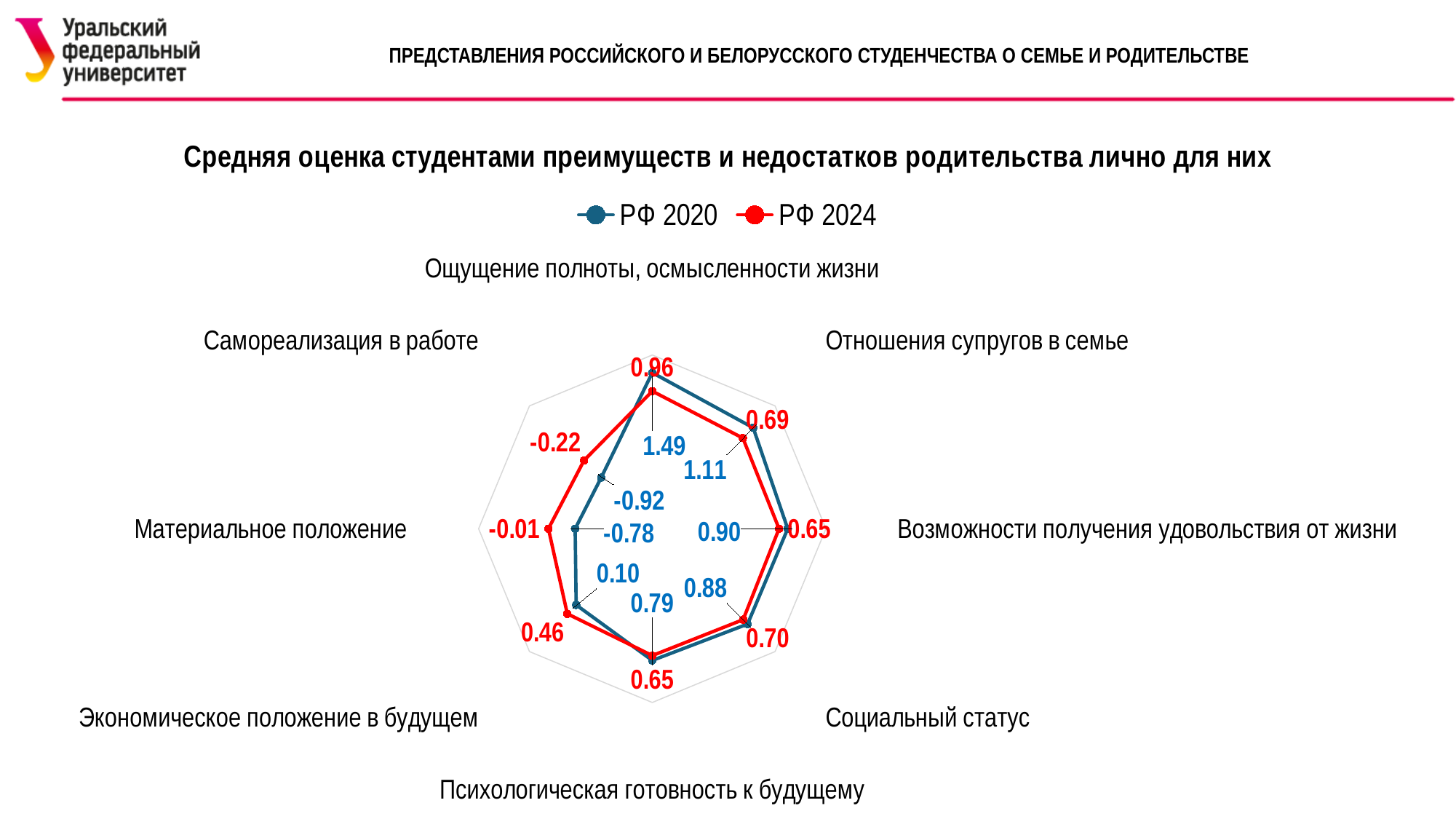
How many categories (axes) does the radar chart have? 8 What is the value for РФ 2020 for 'Самореализация в работе'? -0.92 What kind of chart is shown on the slide? Radar chart What is the difference between the РФ 2020 and РФ 2024 values for 'Отношения супругов в семье'? 0.42 Which category has the highest value for РФ 2020? Ощущение полноты, осмысленности жизни What is the value for РФ 2024 for 'Ощущение полноты, осмысленности жизни'? 0.96 What is the value for РФ 2024 for 'Материальное положение'? -0.01 For 'Экономическое положение в будущем', which series has the larger value, РФ 2020 or РФ 2024? РФ 2024 What is the value for РФ 2020 for 'Ощущение полноты, осмысленности жизни'? 1.49 How many series does the legend list? 2 Which series is drawn in red? РФ 2024 Which category has the lowest value for РФ 2024? Самореализация в работе